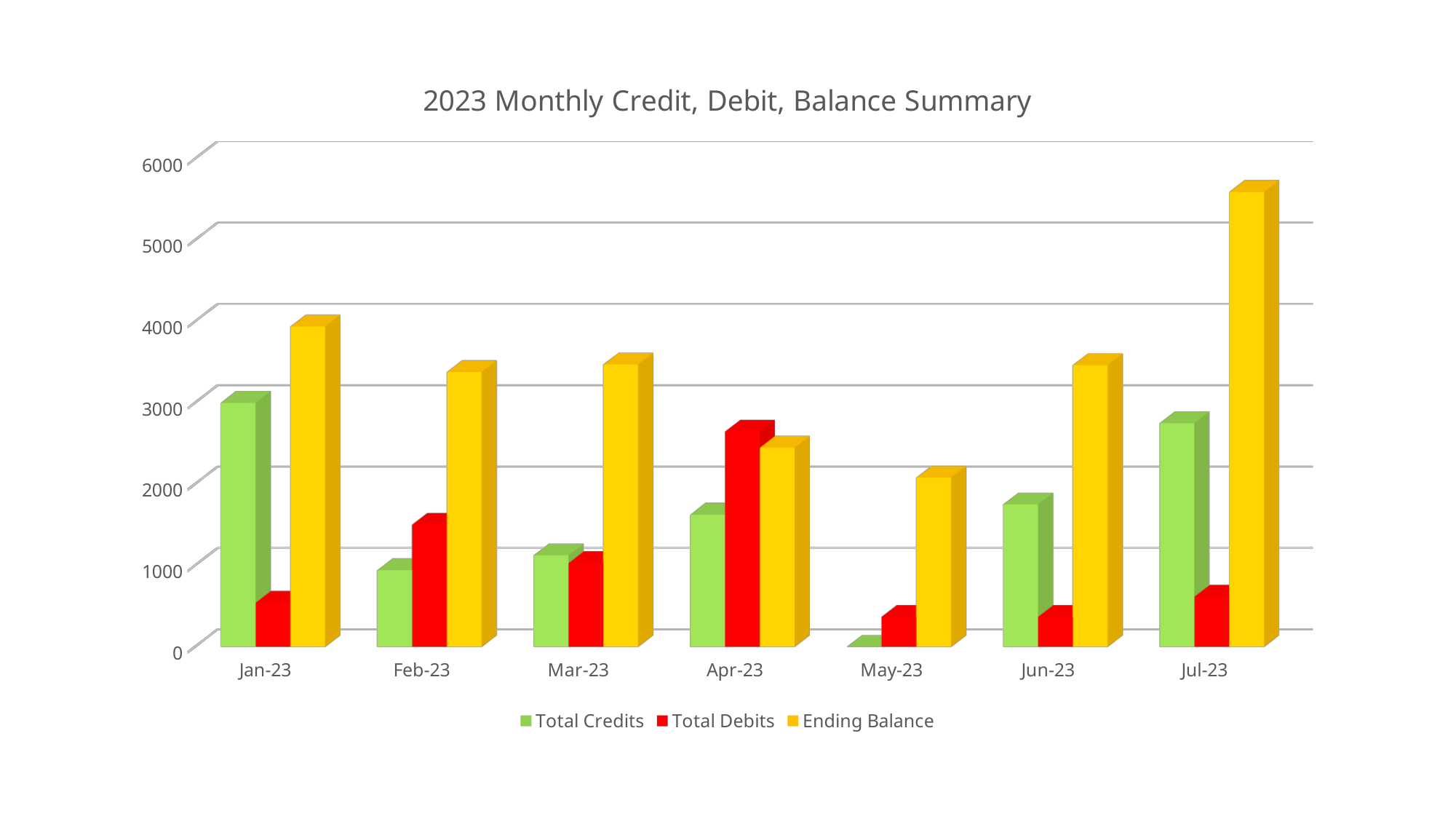
What kind of chart is shown on the slide? Bar chart How many months are shown on the x axis? 7 Which month has the lowest Ending Balance? May-23 How many series does the legend list? 3 What is the title of the chart? 2023 Monthly Credit, Debit, Balance Summary Which month has the highest Total Debits? Apr-23 Is the Ending Balance for Jul-23 greater or less than 5000? greater Is the value of Total Debits for Apr-23 greater or less than 2000? greater Which month has the highest Ending Balance? Jul-23 Which month has the highest Total Credits? Jan-23 In Apr-23, which is larger: Total Credits or Total Debits? Total Debits